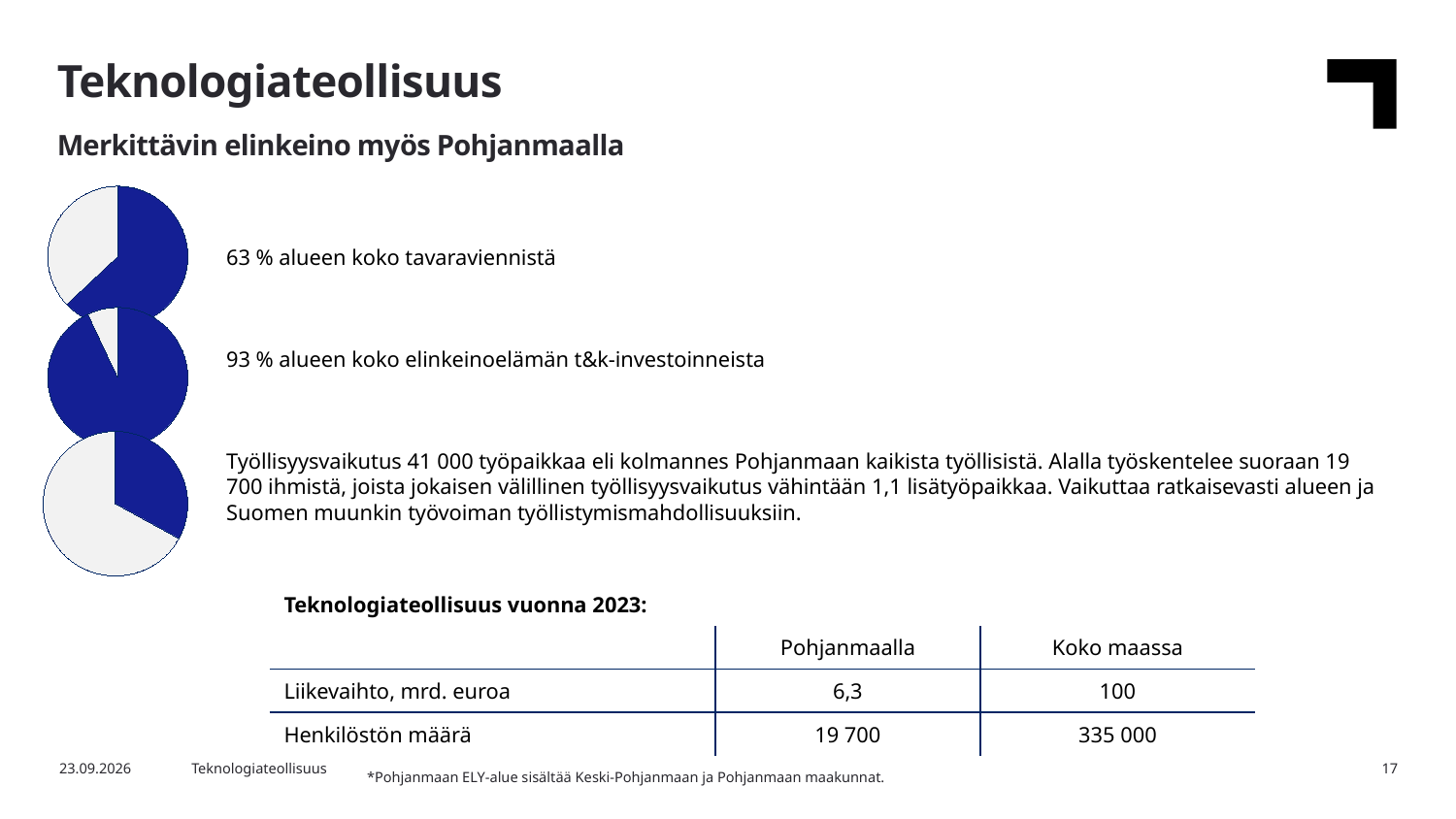
Which of the three pie charts (top, middle or bottom) has the largest blue slice? middle According to the text next to the middle pie chart, what share of the region's business R&D investments (t&k-investoinnit) does the technology industry account for? 93 % How many pie charts are on the slide? 3 Which of the three pie charts (top, middle or bottom) has the smallest blue slice? bottom What kind of charts are shown on the left side of the slide? pie charts Is the blue slice of the bottom pie chart more or less than half of the pie? less How many slices does each pie chart on the slide have? 2 According to the text next to the top pie chart, what share of the region's total goods exports (tavaravienti) does the technology industry account for? 63 % Is the blue slice of the top pie chart more or less than half of the pie? more Is the blue slice in the top pie chart larger or smaller than the blue slice in the middle pie chart? smaller What colour is used for the highlighted slice in the pie charts? blue